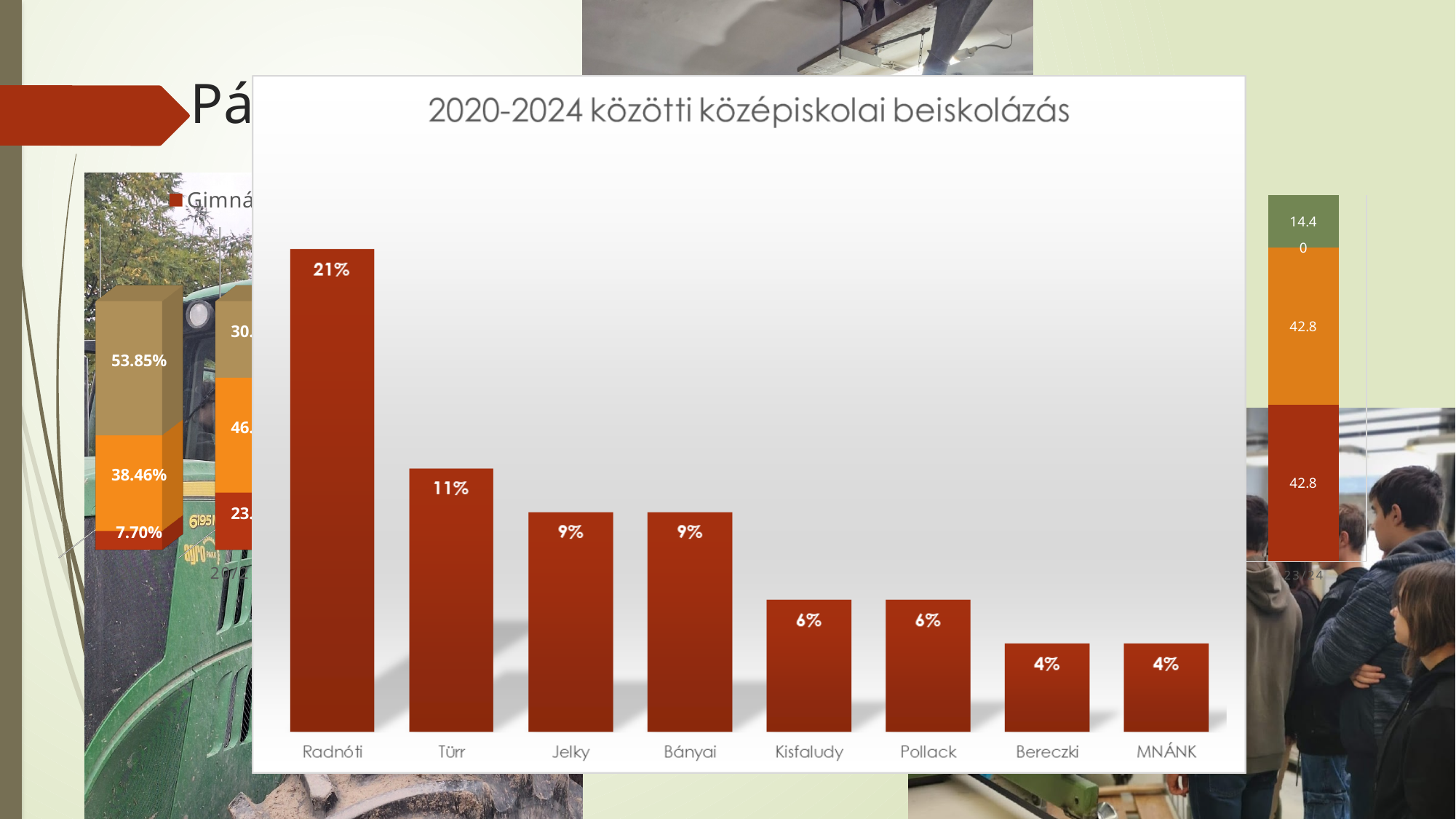
In the chart titled "2020-2024 közötti középiskolai beiskolázás", what is the difference between the values for Jelky and Bereczki? 5% In the chart titled "2020-2024 közötti középiskolai beiskolázás", which is larger, the value for Türr or the value for Pollack? Türr In the chart titled "2020-2024 közötti középiskolai beiskolázás", what is the difference between the values for Radnóti and Türr? 10% In the chart titled "2020-2024 közötti középiskolai beiskolázás", what is the value for Türr? 11% In the chart titled "2020-2024 közötti középiskolai beiskolázás", what is the value for Radnóti? 21% In the chart titled "2020-2024 közötti középiskolai beiskolázás", do the values generally rise or fall from left to right along the x axis? Fall In the chart titled "2020-2024 közötti középiskolai beiskolázás", what is the value for Kisfaludy? 6% What kind of chart is the one titled "2020-2024 közötti középiskolai beiskolázás"? Bar chart What is the title of the large chart in the centre of the slide? 2020-2024 közötti középiskolai beiskolázás In the chart titled "2020-2024 közötti középiskolai beiskolázás", how many categories are shown on the x axis? 8 In the chart titled "2020-2024 közötti középiskolai beiskolázás", which category has the highest value? Radnóti In the chart titled "2020-2024 közötti középiskolai beiskolázás", what is the value for MNÁNK? 4%